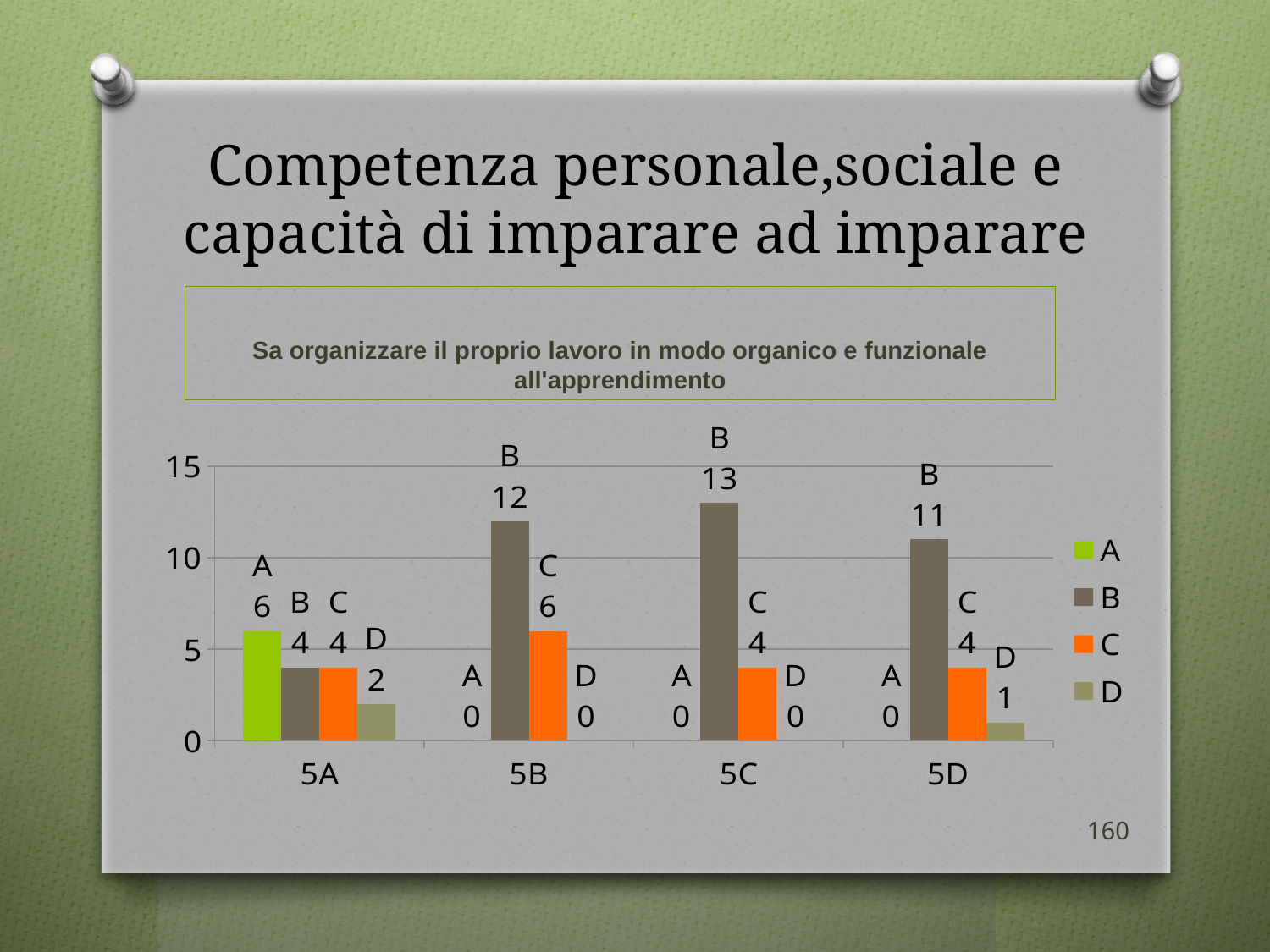
How many series does the legend list? 4 Which category has the lowest value for series B? 5A What is the value of series D for category 5D? 1 How many categories are shown on the x axis? 4 Which category has the highest value for series B? 5C What is the difference between the B values for 5B and 5D? 1 What is the value of series A for category 5A? 6 What is the text in the box above the chart? Sa organizzare il proprio lavoro in modo organico e funzionale all'apprendimento What is the value of series C for category 5B? 6 What kind of chart is shown on the slide? bar chart What is the value of series B for category 5C? 13 Which is larger: the C value for 5A or the C value for 5B? 5B